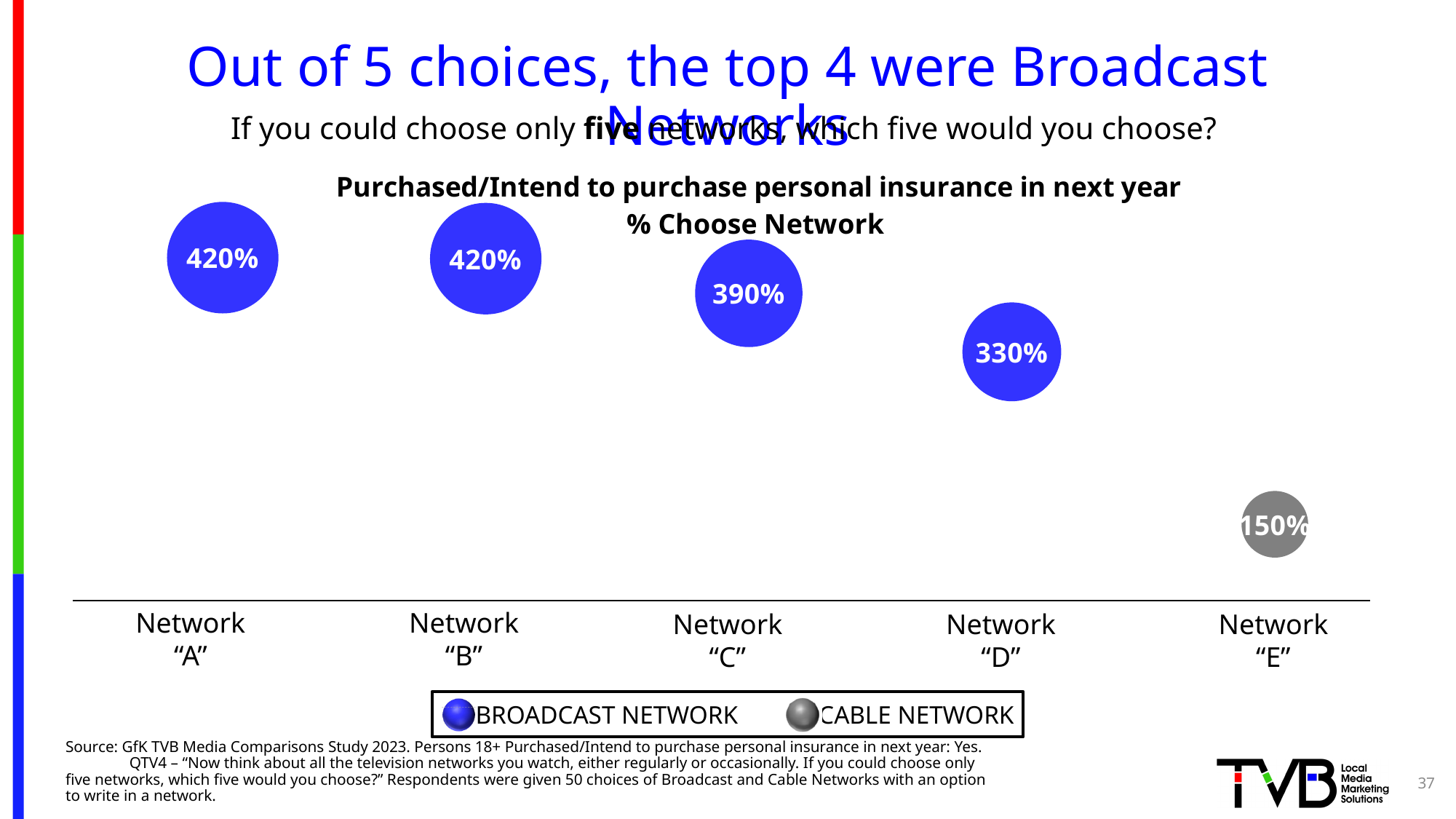
How many entries does the legend list? 2 What is the difference between the values for Network "A" and Network "E"? 270% What is the value for Network "E"? 150% Which network is shown as a Cable Network in the chart? Network "E" How many networks are plotted on the chart? 5 Which network has the lowest value? Network "E" Which is larger, the value for Network "B" or the value for Network "D"? Network "B" What is the value for Network "C"? 390% What colour are the bubbles for Broadcast Networks? blue Do the values rise or fall from Network "A" to Network "E"? fall What is the value for Network "D"? 330% What is the difference between the values for Network "C" and Network "D"? 60%